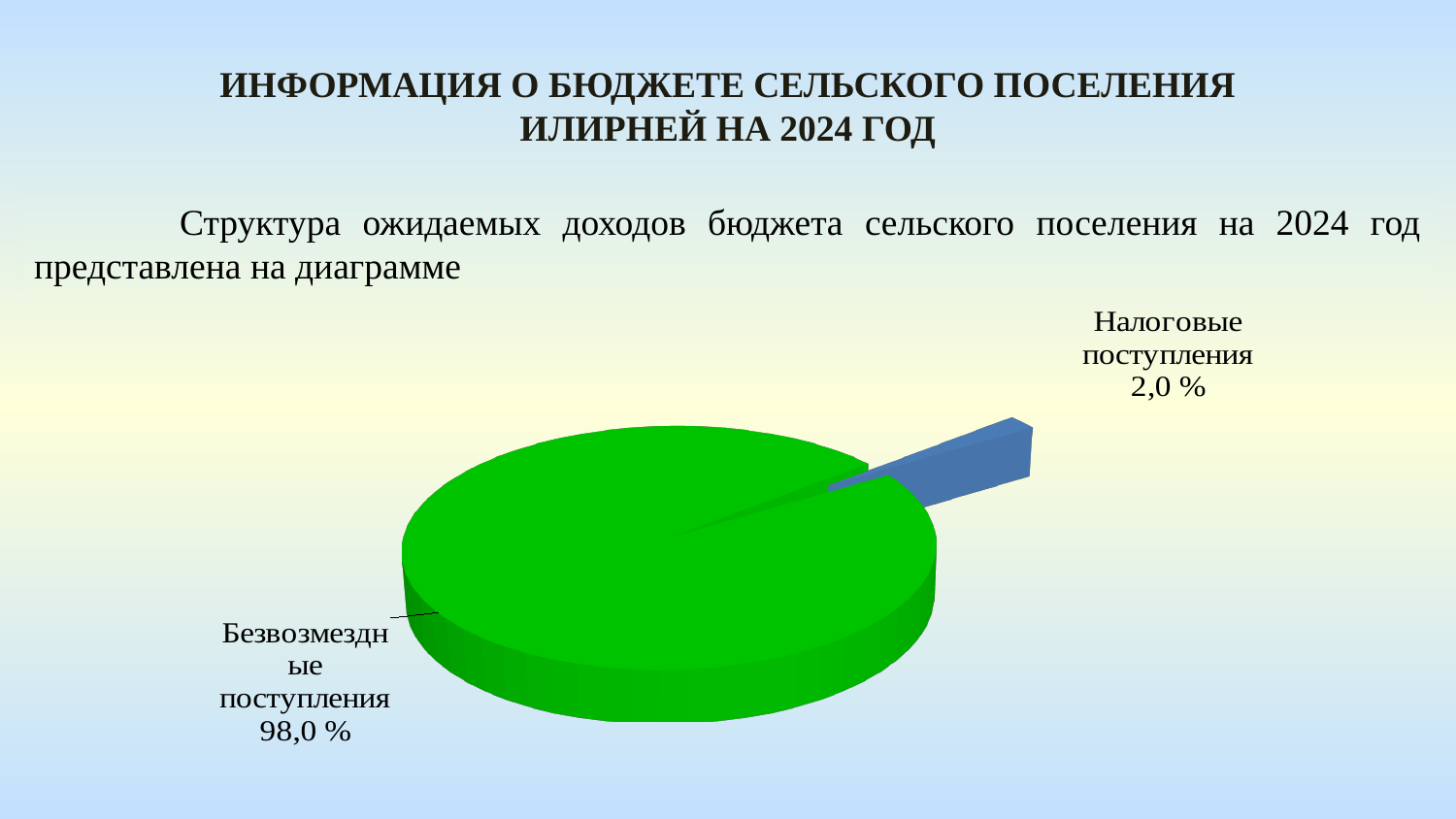
Which category has the smallest slice of the pie? Налоговые поступления How many slices does the pie chart have? 2 What is the total of the two slices shown in the pie chart? 100,0 % What kind of chart is shown on the slide? pie chart What is the difference in percentage points between "Безвозмездные поступления" and "Налоговые поступления"? 96,0 % What share of the pie does "Налоговые поступления" have? 2,0 % What colour is the slice for "Налоговые поступления"? blue What share of the pie does "Безвозмездные поступления" have? 98,0 % What colour is the slice for "Безвозмездные поступления"? green Which is larger: the share of "Налоговые поступления" or the share of "Безвозмездные поступления"? Безвозмездные поступления Which category has the largest slice of the pie? Безвозмездные поступления